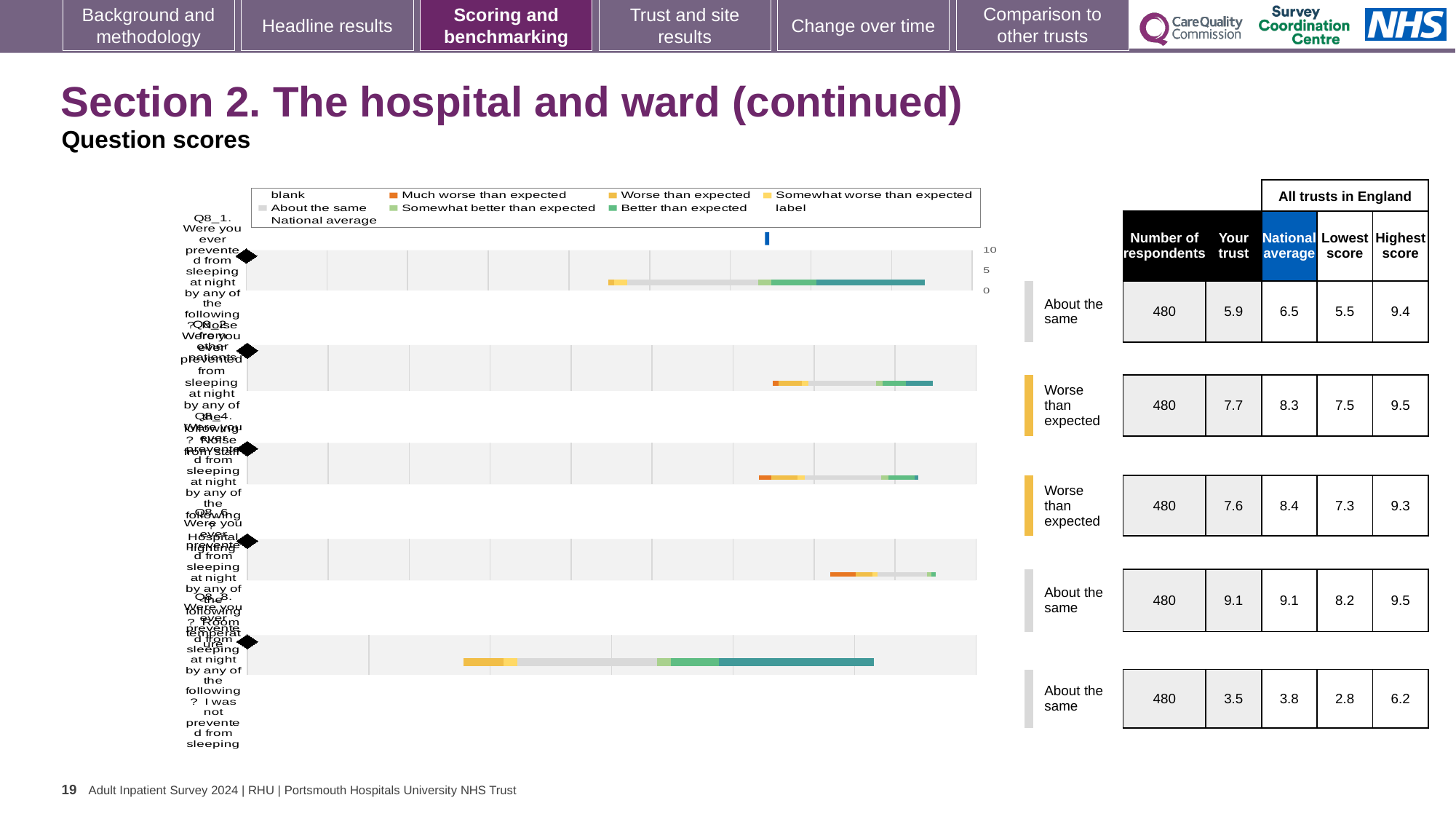
Which question row has the highest 'Your trust' score in the table beside the charts? the fourth row (9.1) In the table beside the charts, what is the national average for the second question row? 8.3 For the third question row, which is larger: the 'Your trust' score or the national average? national average How many respondents are listed for each question row in the table beside the charts? 480 In the table beside the charts, what is the 'Your trust' score for the first (top) question row? 5.9 For the first question row, what is the difference between the national average and the 'Your trust' score? 0.6 What benchmark category label is shown next to the second question row? Worse than expected What kind of chart is used to show the question scores on this slide? bar chart How many question rows (bars) are plotted in the chart area? 5 What is the highest tick value shown on the chart's axis? 10 Which question row has the lowest 'Your trust' score in the table beside the charts? the fifth row (3.5) What is the highest score among all trusts in England for the fifth question row? 6.2